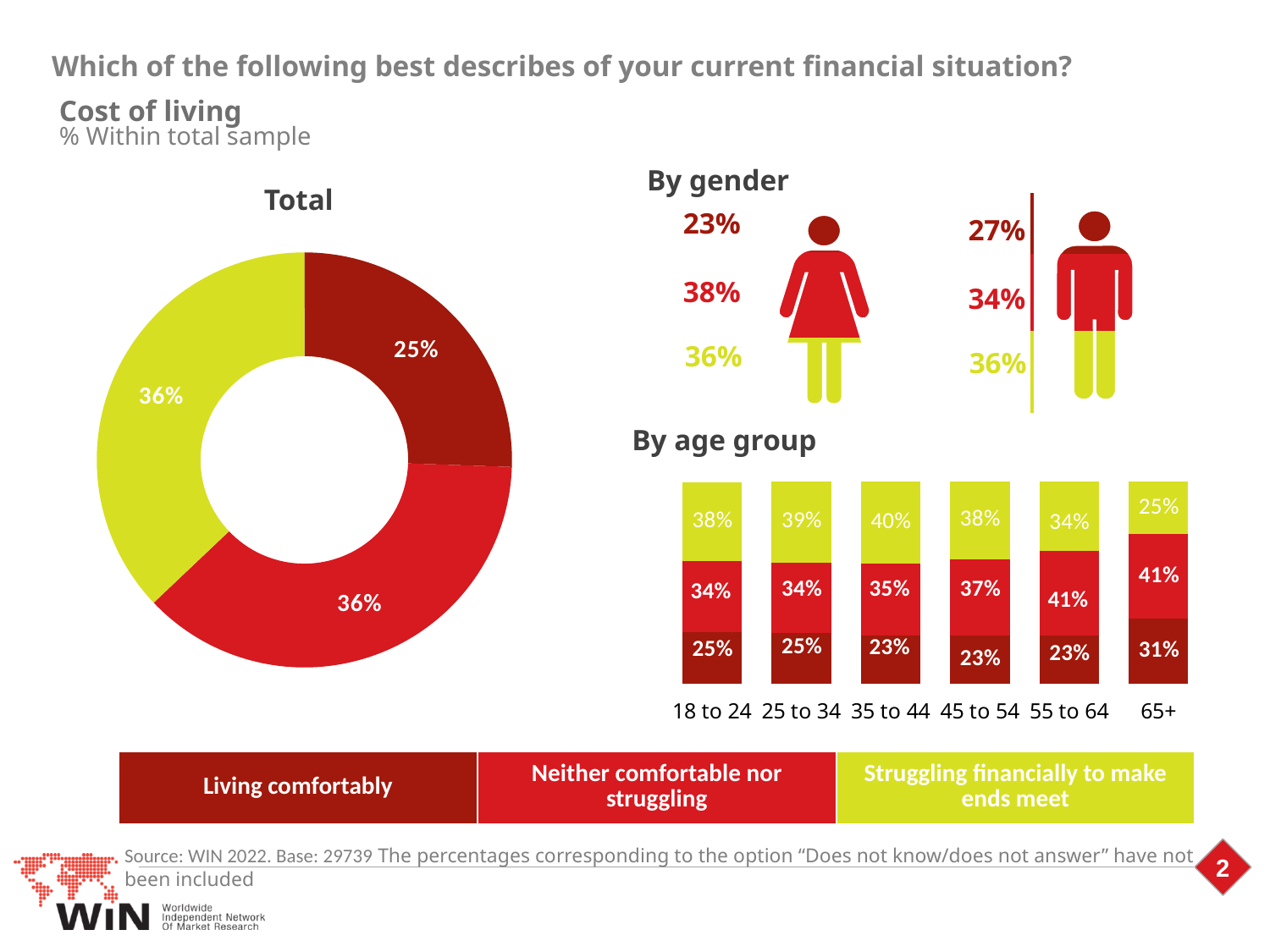
In the 'By age group' chart, how many age groups are shown? 6 In the 'Total' chart, what share of respondents are living comfortably? 25% In the 'By age group' chart, which age group has the highest value for 'Living comfortably'? 65+ In the 'By gender' section, what percentage of women are living comfortably? 23% What kind of chart is the 'Total' chart? Donut (pie) chart In the 'By age group' chart, what is the value for 'Struggling financially to make ends meet' in the 35 to 44 age group? 40% What kind of chart is the 'By age group' chart? Stacked bar chart How many categories does the legend at the bottom of the slide list? 3 In the 'By age group' chart, what is the value for 'Living comfortably' in the 65+ age group? 31% In the 'By gender' section, is the 'Living comfortably' value larger for men or for women? Men In the 'By age group' chart, what is the difference between the 'Neither comfortable nor struggling' values for 55 to 64 and 18 to 24? 7% In the 'By age group' chart, which age group has the lowest value for 'Struggling financially to make ends meet'? 65+